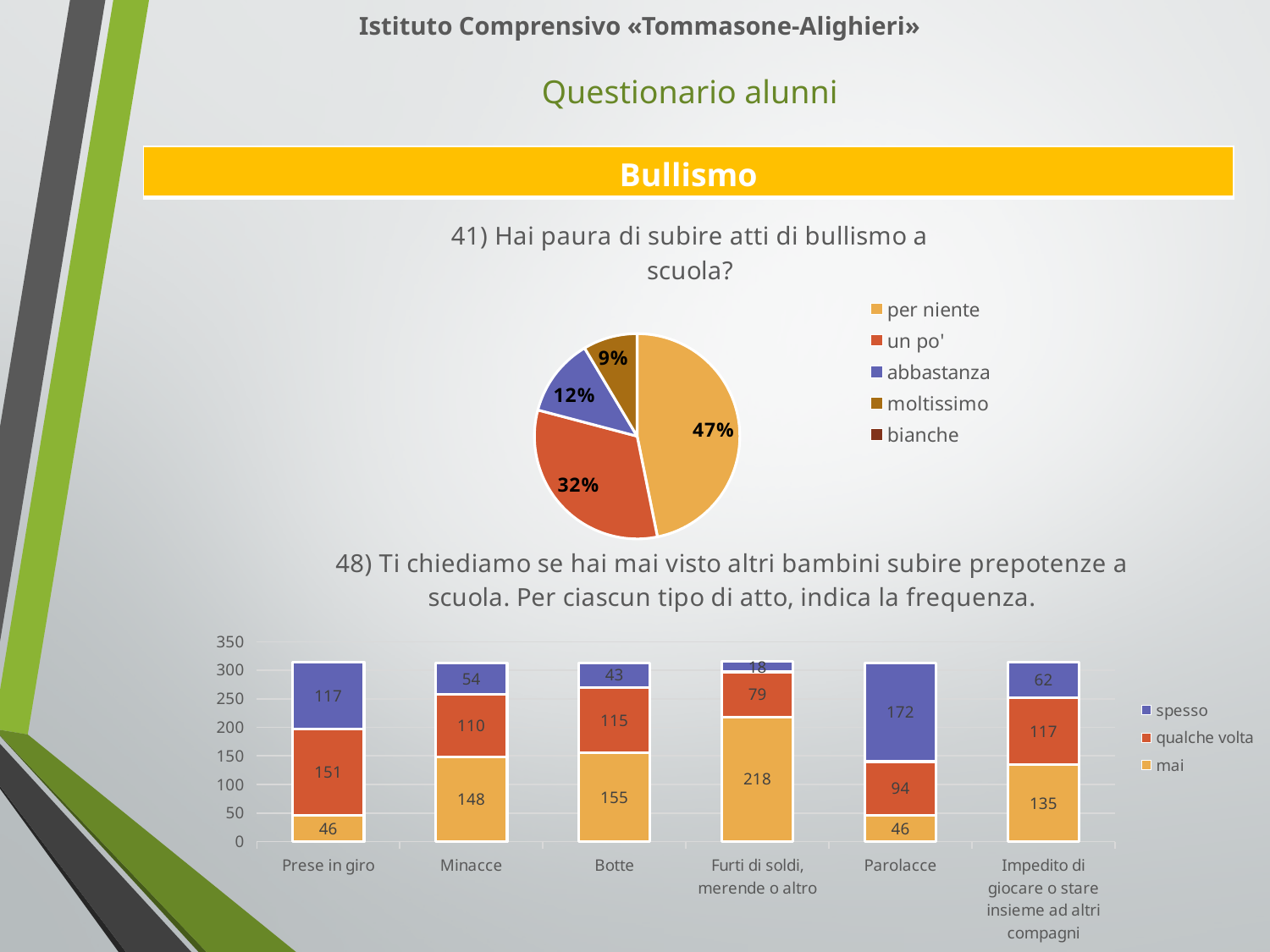
In the pie chart for question 41, which answer has the largest slice? per niente How many entries does the legend of the pie chart for question 41 list? 5 In the bar chart for question 48, which category has the highest "mai" value? Furti di soldi, merende o altro In the bar chart for question 48, what is the total of the stacked bar for "Prese in giro"? 314 How many categories are shown on the x axis of the bar chart for question 48? 6 In the bar chart for question 48, what is the "spesso" value for "Parolacce"? 172 In the bar chart for question 48, what is the difference between the "qualche volta" values for "Prese in giro" and "Minacce"? 41 In the pie chart for question 41, what percentage of pupils answered "per niente"? 47% In the bar chart for question 48, which category has the highest "spesso" value? Parolacce In the pie chart for question 41, which answer has the smallest percentage label shown? moltissimo What kind of chart is used for question 48? Stacked bar chart In the bar chart for question 48, what is the "mai" value for "Furti di soldi, merende o altro"? 218